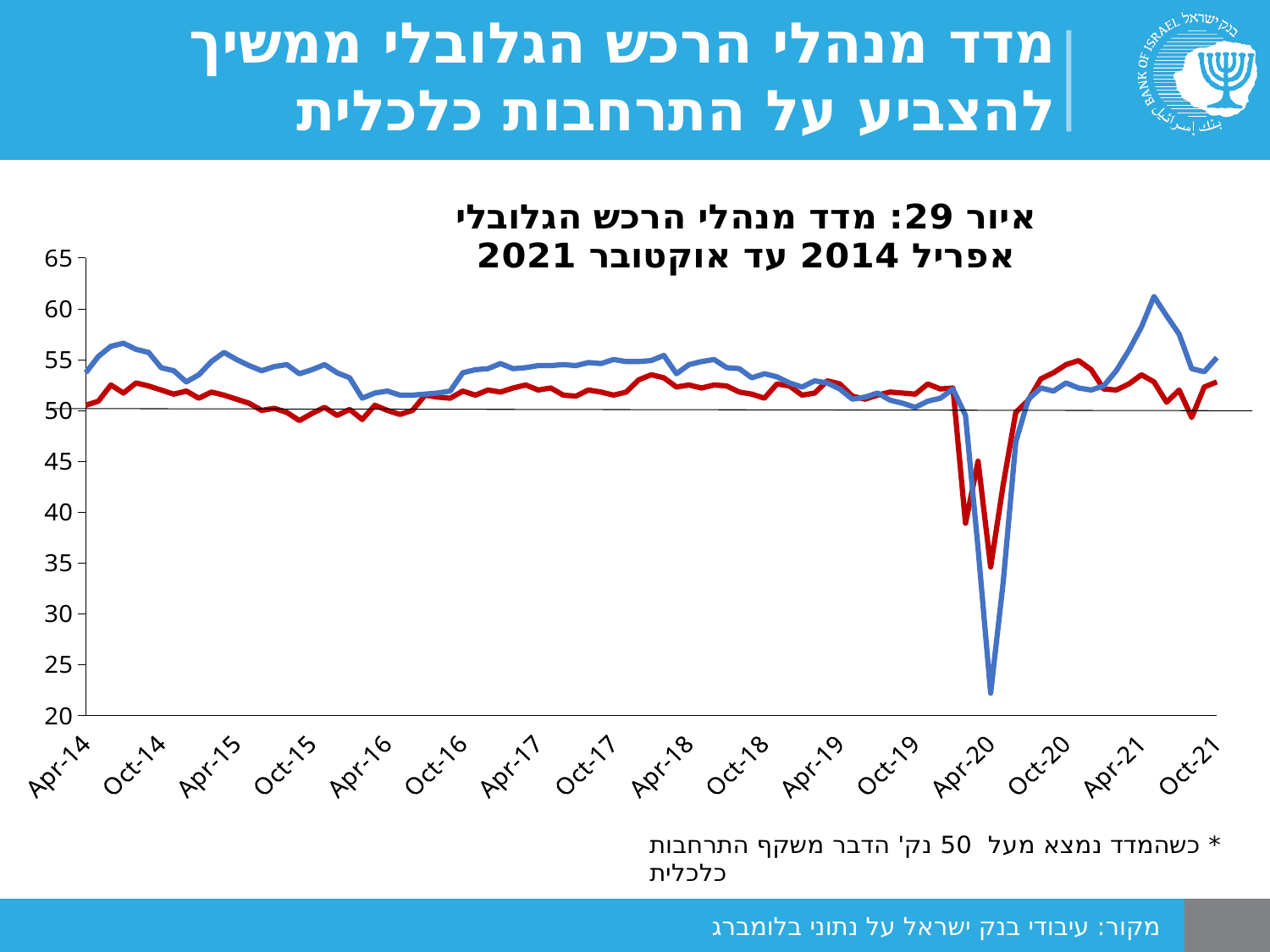
Is the value of the blue line at Apr-20 greater or less than 30? less At Apr-21, which line is higher, the blue line or the red line? blue line How many lines (series) are plotted on the chart? 2 How many labels are shown on the x axis of the chart? 16 At Apr-20, which line is lower, the blue line or the red line? blue line Is the value of the blue line at Apr-21 greater or less than 55? greater Is the value of the blue line at Apr-18 greater or less than 50? greater What is the last label on the x axis? Oct-21 What kind of chart is shown on the slide? line chart Around which x-axis label does the blue line reach its lowest value? Apr-20 What is the first label on the x axis? Apr-14